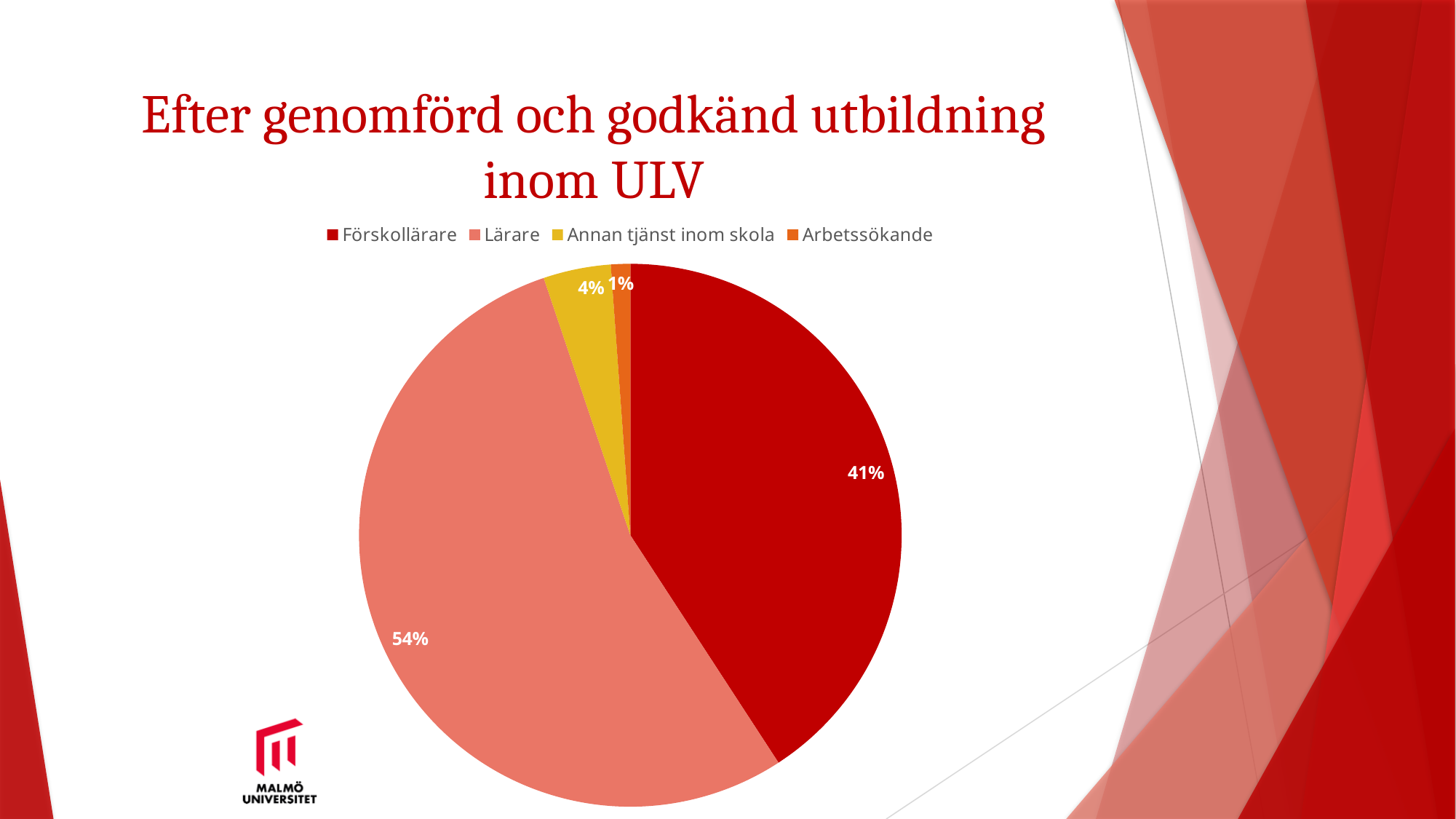
What kind of chart is shown on the slide? pie chart What share of the pie does Förskollärare have? 41% What is the difference in percentage points between Lärare and Förskollärare? 13 What share of the pie does Arbetssökande have? 1% Which is larger, the slice for Förskollärare or the slice for Annan tjänst inom skola? Förskollärare What share of the pie does Lärare have? 54% Which colour represents Annan tjänst inom skola in the legend? yellow How many categories does the pie chart have? 4 What is the title of the slide containing the chart? Efter genomförd och godkänd utbildning inom ULV Which category has the smallest slice of the pie? Arbetssökande Which category has the largest slice of the pie? Lärare